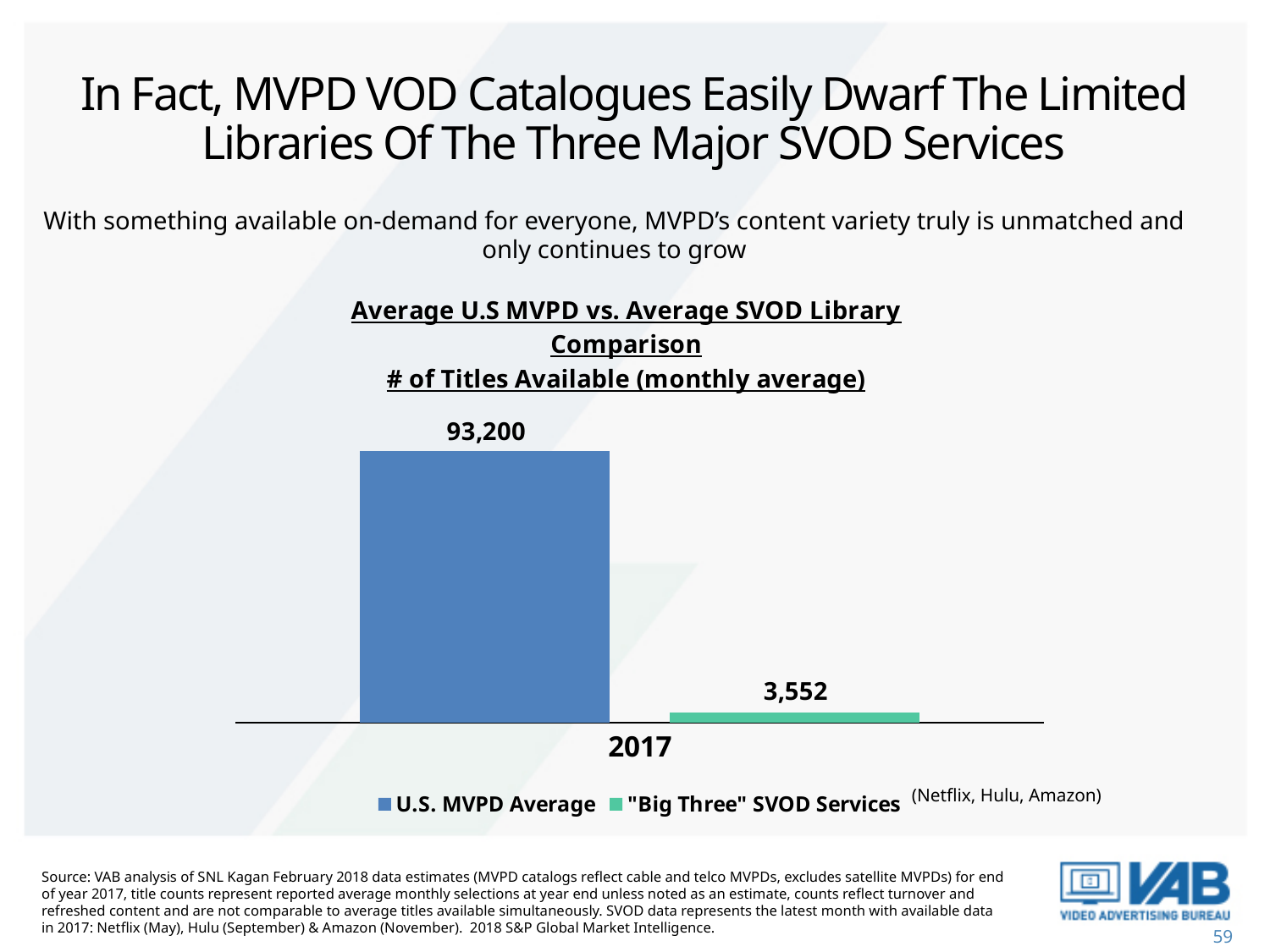
What is the difference between the U.S. MVPD Average and the "Big Three" SVOD Services values in 2017? 89,648 Which series has the lower value in 2017? "Big Three" SVOD Services Which year is shown on the x axis of the chart? 2017 Which three services make up the "Big Three" SVOD Services series according to the note next to the legend? Netflix, Hulu, Amazon Which series has the higher value in 2017? U.S. MVPD Average How many categories are shown on the x axis? 1 Is the value for U.S. MVPD Average larger or smaller than the value for "Big Three" SVOD Services? larger What is the value for U.S. MVPD Average in 2017? 93,200 What is the value for "Big Three" SVOD Services in 2017? 3,552 What kind of chart is shown on the slide? bar chart How many series does the legend list? 2